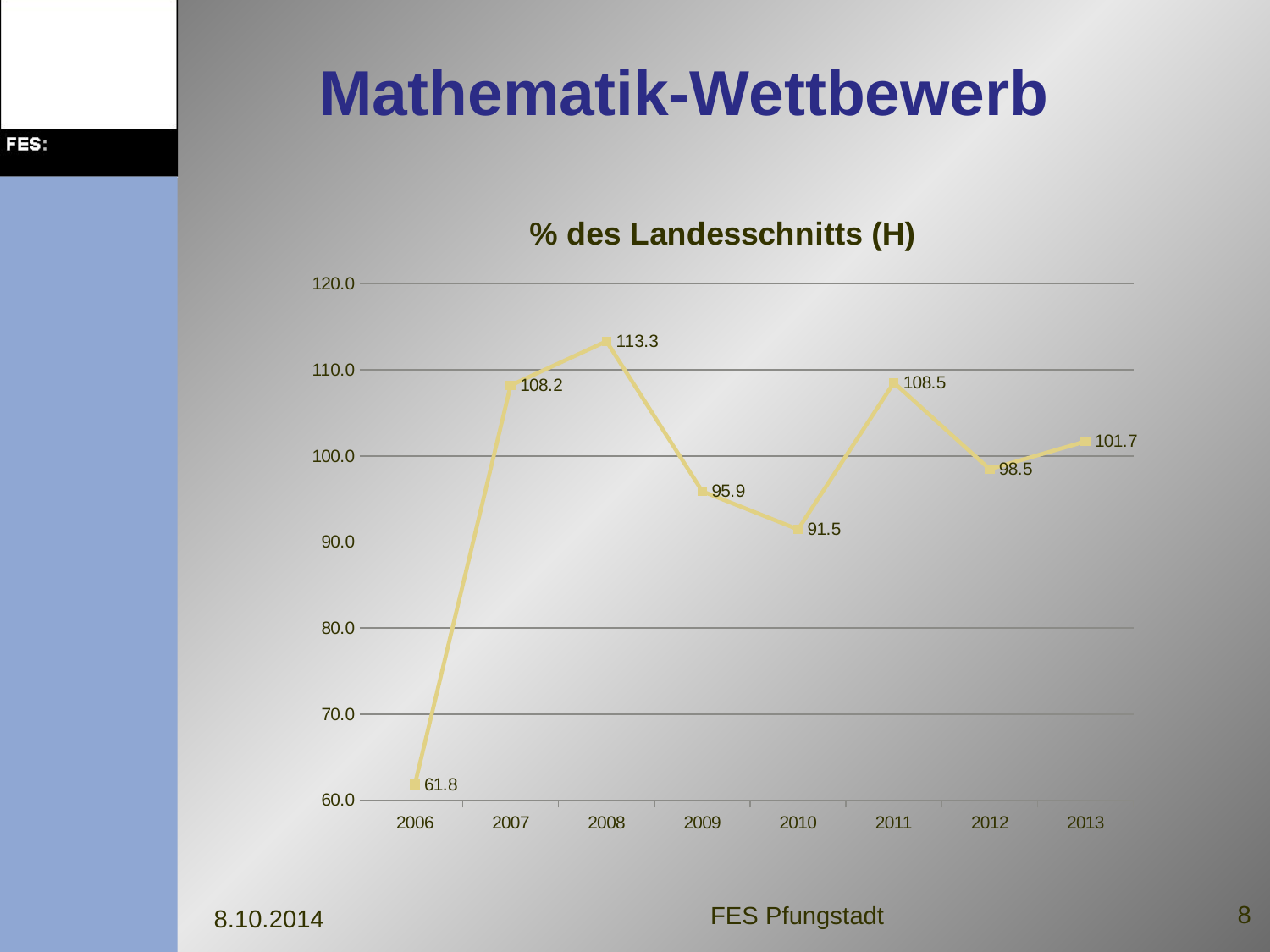
Do the values rise or fall from 2006 to 2008? rise What kind of chart is shown? line chart What is the value for 2008? 113.3 Which is larger, the value for 2007 or the value for 2011? 2011 What is the difference between the values for 2008 and 2010? 21.8 How many years are plotted on the chart? 8 Which year has the lowest value? 2006 Is the value for 2009 greater or less than 100.0? less What is the value for 2012? 98.5 Which year has the highest value? 2008 What is the title of the chart? % des Landesschnitts (H) What is the value for 2006? 61.8